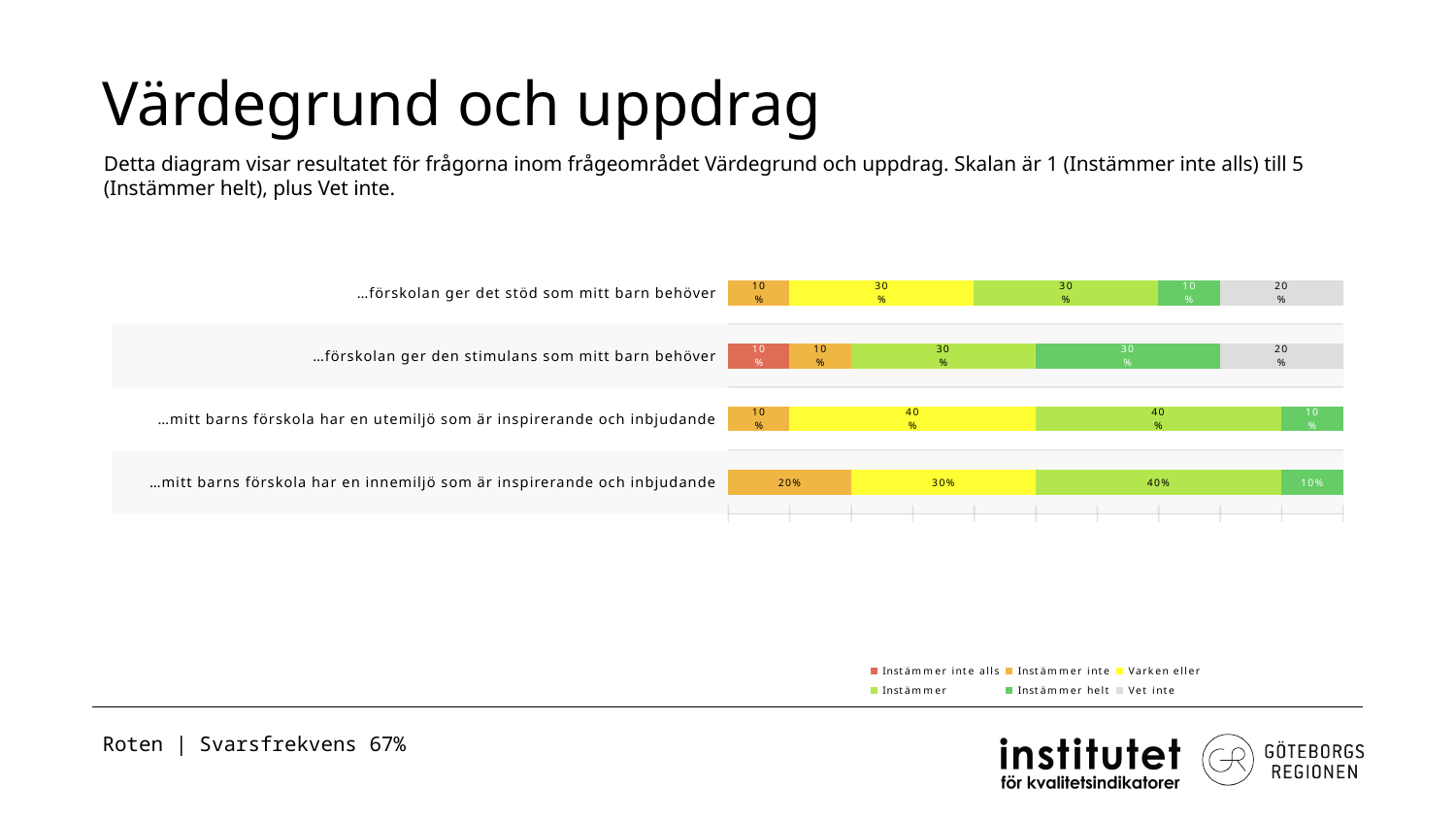
Which has the larger 'Instämmer inte' share: the innemiljö statement or the utemiljö statement? The innemiljö statement (20%) How many series does the legend list? 6 What is the 'Instämmer' share for '…mitt barns förskola har en innemiljö som är inspirerande och inbjudande'? 40% What is the 'Instämmer helt' share for '…förskolan ger den stimulans som mitt barn behöver'? 30% What is the difference in 'Instämmer helt' share between '…förskolan ger den stimulans som mitt barn behöver' and '…förskolan ger det stöd som mitt barn behöver'? 20 percentage points What is the total of the stacked bar for '…mitt barns förskola har en utemiljö som är inspirerande och inbjudande'? 100% How many statements (categories) are plotted in the chart? 4 Which statement has the highest 'Instämmer helt' share? …förskolan ger den stimulans som mitt barn behöver What kind of chart is shown on the slide? Stacked bar chart What is the 'Vet inte' share for '…förskolan ger det stöd som mitt barn behöver'? 20% What is the 'Varken eller' share for '…mitt barns förskola har en utemiljö som är inspirerande och inbjudande'? 40% What is the title of the slide containing the chart? Värdegrund och uppdrag